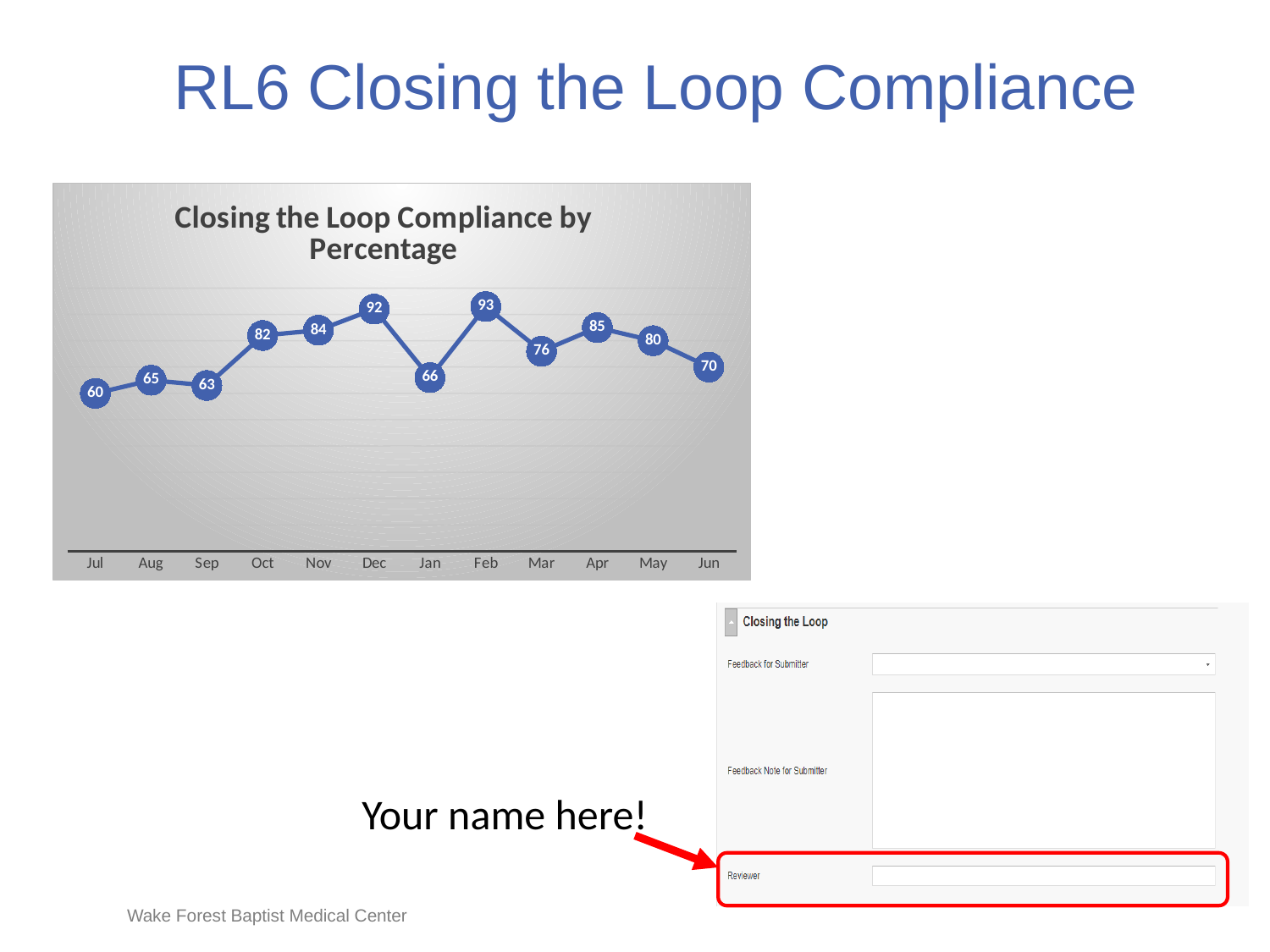
What is the value for Jun? 70 What is the value for Jul? 60 What is the difference between the values for Apr and May? 5 Do the values rise or fall from Jul to Oct? rise What is the value for Feb? 93 What is the title of the chart? Closing the Loop Compliance by Percentage Which month has the lowest value? Jul What is the difference between the values for Dec and Jan? 26 How many months are plotted on the chart? 12 Which is larger, the value for Oct or the value for Mar? Oct What kind of chart is shown? line chart Which month has the highest value? Feb